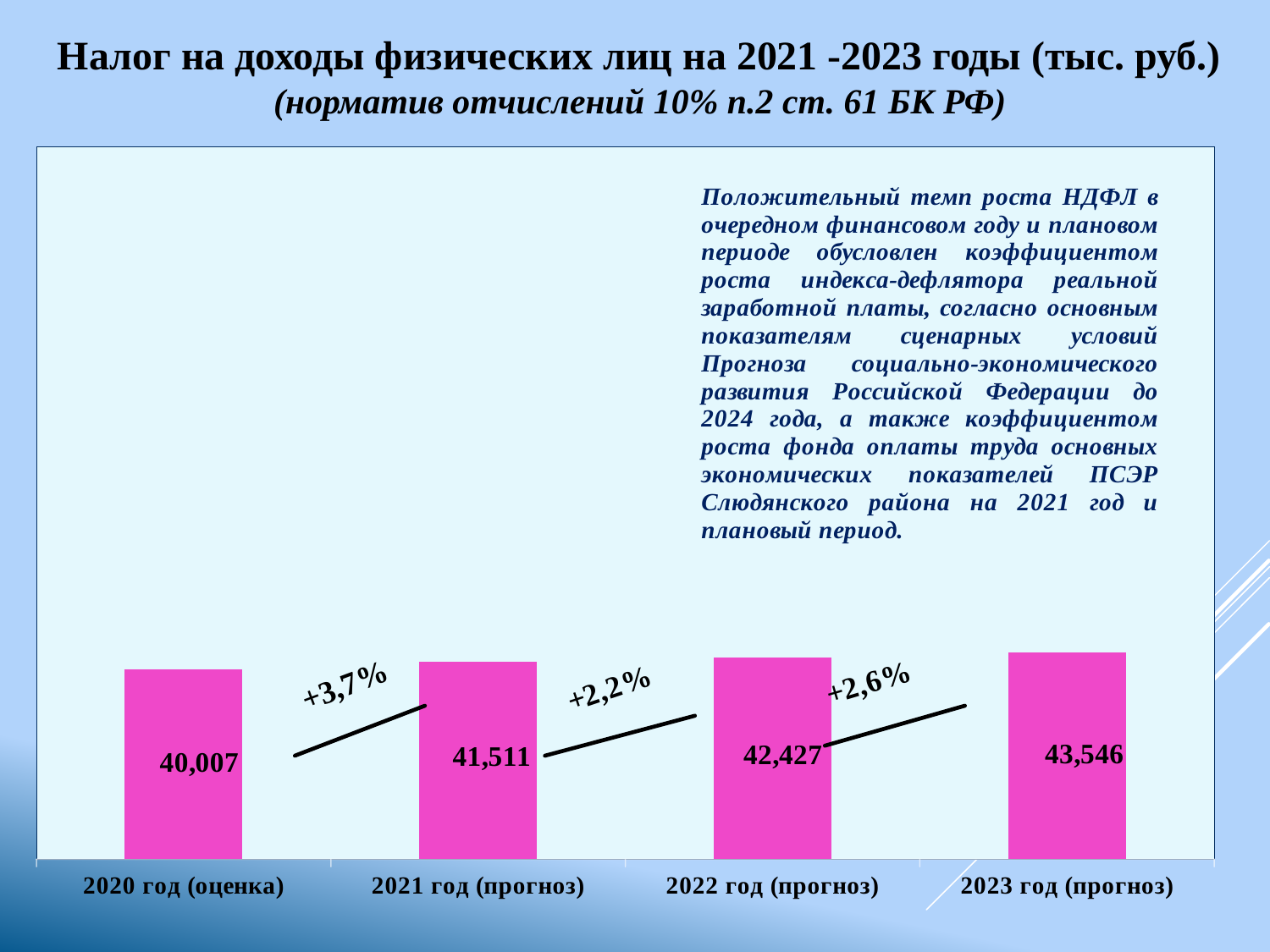
Which is larger, the value for 2022 год (прогноз) or the value for 2021 год (прогноз)? 2022 год (прогноз) How many bars are shown in the chart? 4 What is the value for 2021 год (прогноз)? 41,511 What is the difference between the values for 2023 год (прогноз) and 2020 год (оценка)? 3,539 Which year has the highest value? 2023 год (прогноз) What kind of chart is shown on the slide? bar chart Do the values rise or fall from 2020 to 2023? rise What is the value for 2023 год (прогноз)? 43,546 What is the value for 2020 год (оценка)? 40,007 What is the value for 2022 год (прогноз)? 42,427 What is the difference between the values for 2021 год (прогноз) and 2020 год (оценка)? 1,504 Which year has the lowest value? 2020 год (оценка)